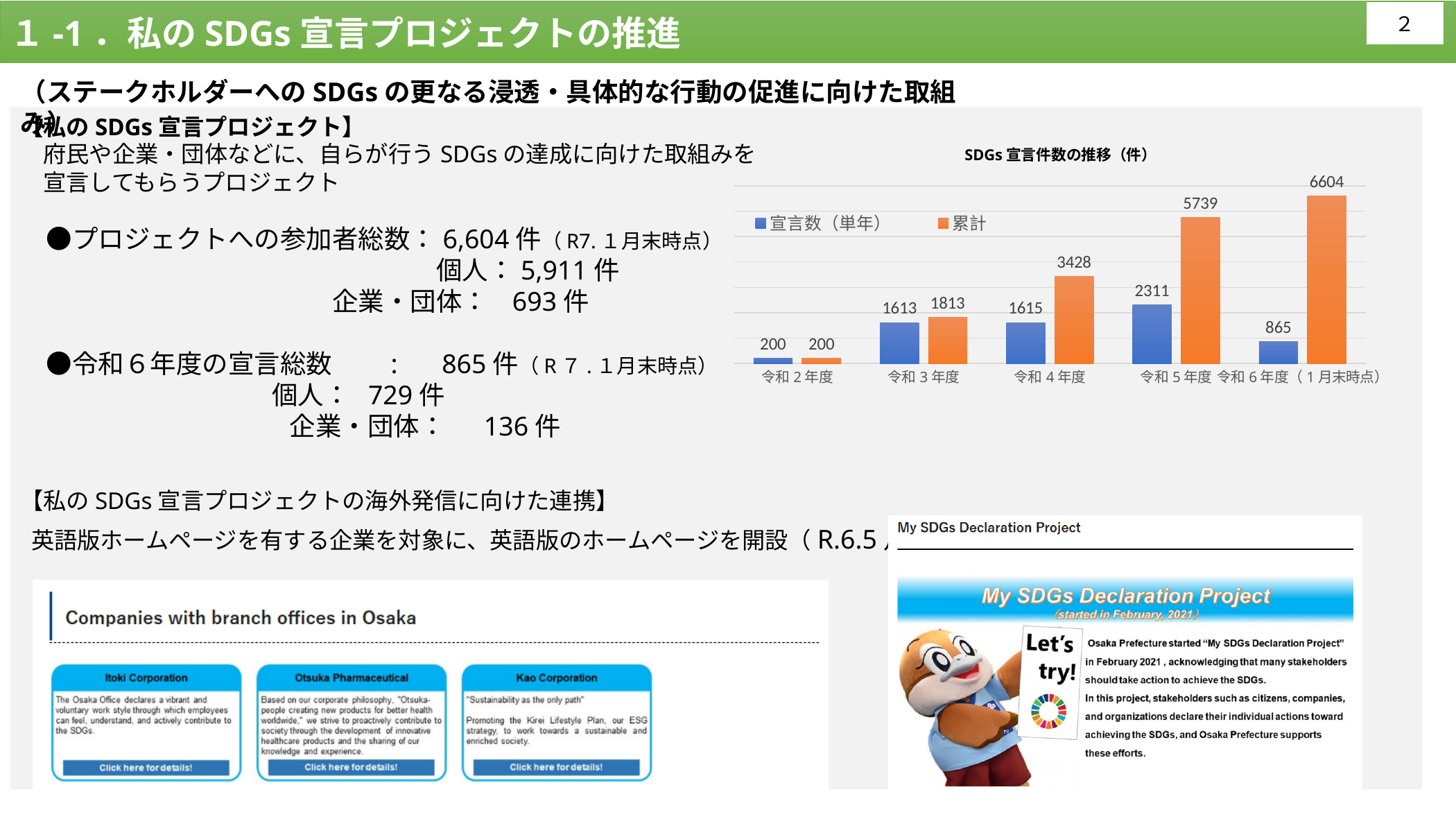
Which fiscal year has the highest 宣言数（単年） value? 令和5年度 What is the title of the chart? SDGs宣言件数の推移（件） How many series does the chart legend list? 2 How many fiscal-year categories are shown on the x axis of the chart? 5 What type of chart is shown on the slide? bar chart What is the 宣言数（単年） value for 令和5年度? 2311 Does the 累計 series rise or fall across the fiscal years on the x axis? rise Which fiscal year has the lowest 累計 value? 令和2年度 Which is larger, the 宣言数（単年） value for 令和3年度 or for 令和6年度（1月末時点）? 令和3年度 What is the 累計 value for 令和4年度? 3428 What is the difference between the 累計 values for 令和5年度 and 令和4年度? 2311 What is the 累計 value for 令和6年度（1月末時点）? 6604